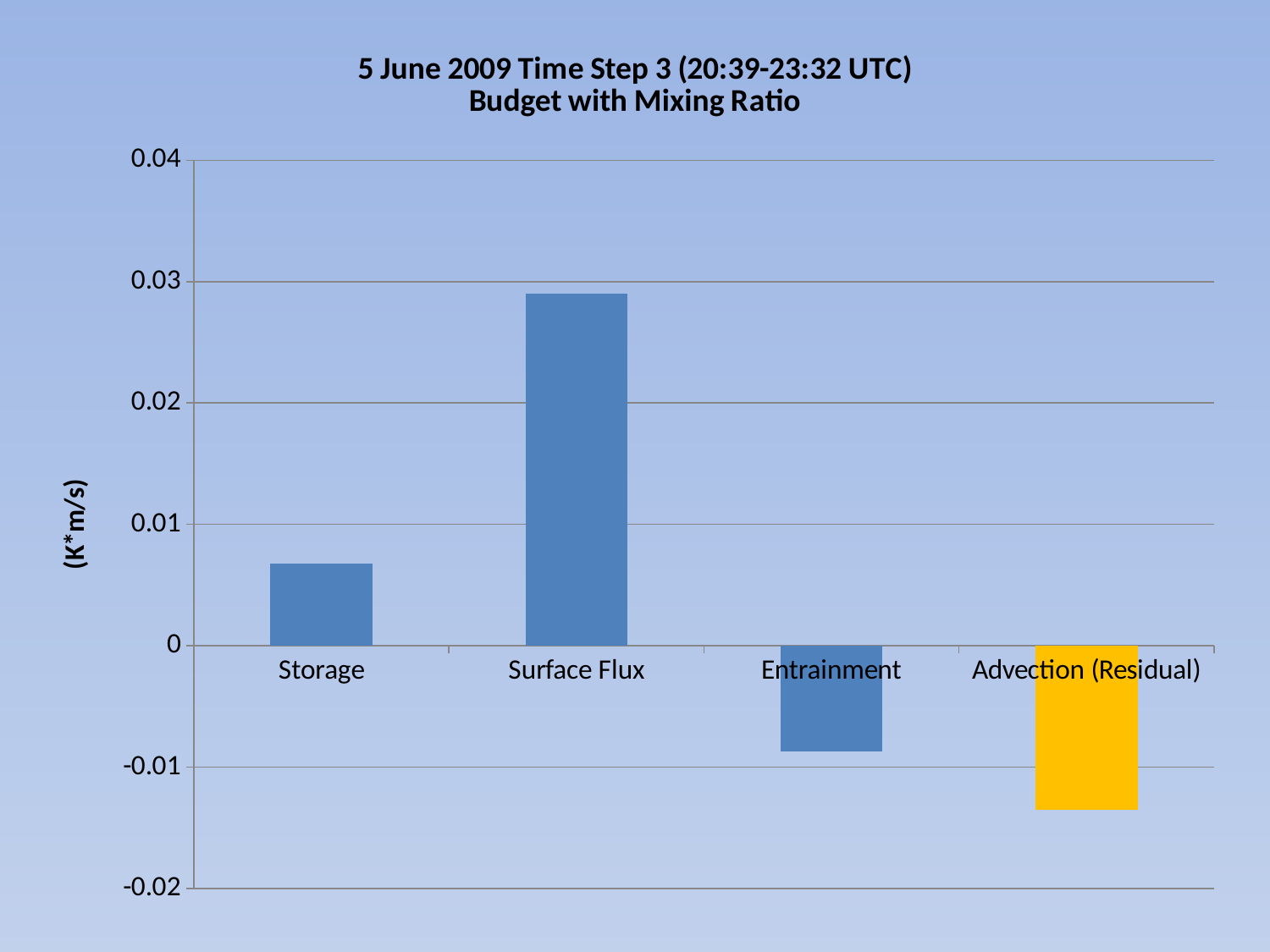
Which category has the lowest value? Advection (Residual) What kind of chart is shown on the slide? Bar chart Is the value for Entrainment greater or less than -0.01? greater Is the value for Advection (Residual) greater or less than -0.01? less Which is larger, the value for Storage or the value for Surface Flux? Surface Flux What is the label on the vertical axis of the chart? (K*m/s) How many categories are plotted on the chart? 4 Which is larger, the value for Entrainment or the value for Advection (Residual)? Entrainment Is the value for Storage greater or less than 0.01? less Which category has the highest value? Surface Flux Which category's bar is coloured differently (yellow) from the others? Advection (Residual)